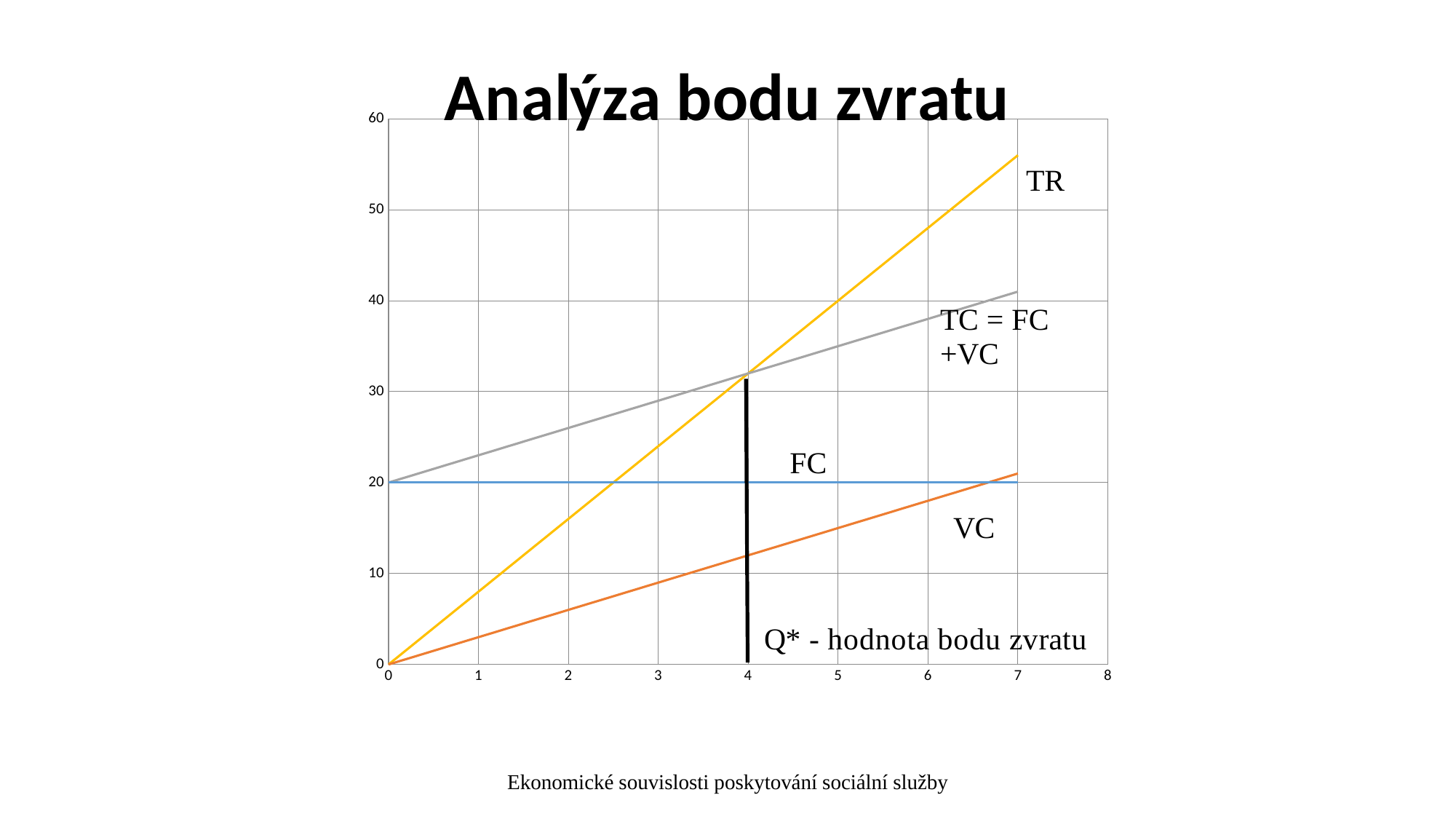
What is the value of TR at x = 5? 40 What is the value of the FC line? 20 What is the title of the chart? Analýza bodu zvratu At x = 2, which is larger, TR or TC? TC Is the value of VC at x = 6 greater or less than 20? less At what x value is the break-even point Q* marked? 4 Which line has the highest value at x = 7? TR Is the value of TC at x = 2 greater or less than 20? greater Is the value of TR at x = 7 greater or less than 50? greater What kind of chart is shown on the slide? line chart How many lines are plotted on the chart? 4 At x = 7, which is larger, TR or TC? TR